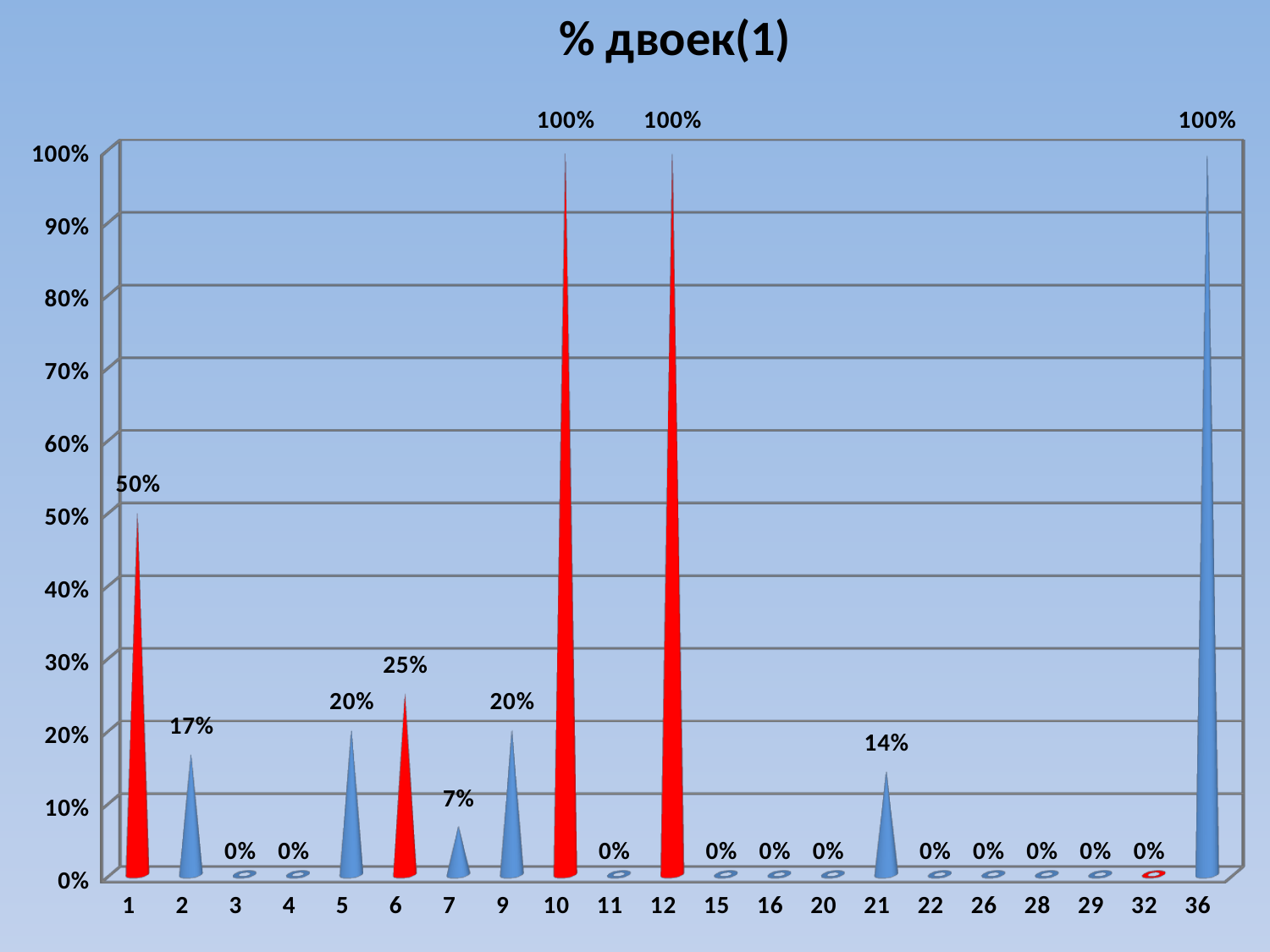
What is the value for category 36? 100% How many categories are shown on the x axis? 21 What is the title of the chart? % двоек(1) What is the value for category 1? 50% What is the value for category 7? 7% Which has a larger value, category 2 or category 21? 2 What is the value for category 21? 14% What is the difference between the values for category 1 and category 2? 33% What is the difference between the values for category 6 and category 5? 5% What is the highest value shown on the chart? 100% What is the value for category 6? 25% Which has a larger value, category 9 or category 7? 9